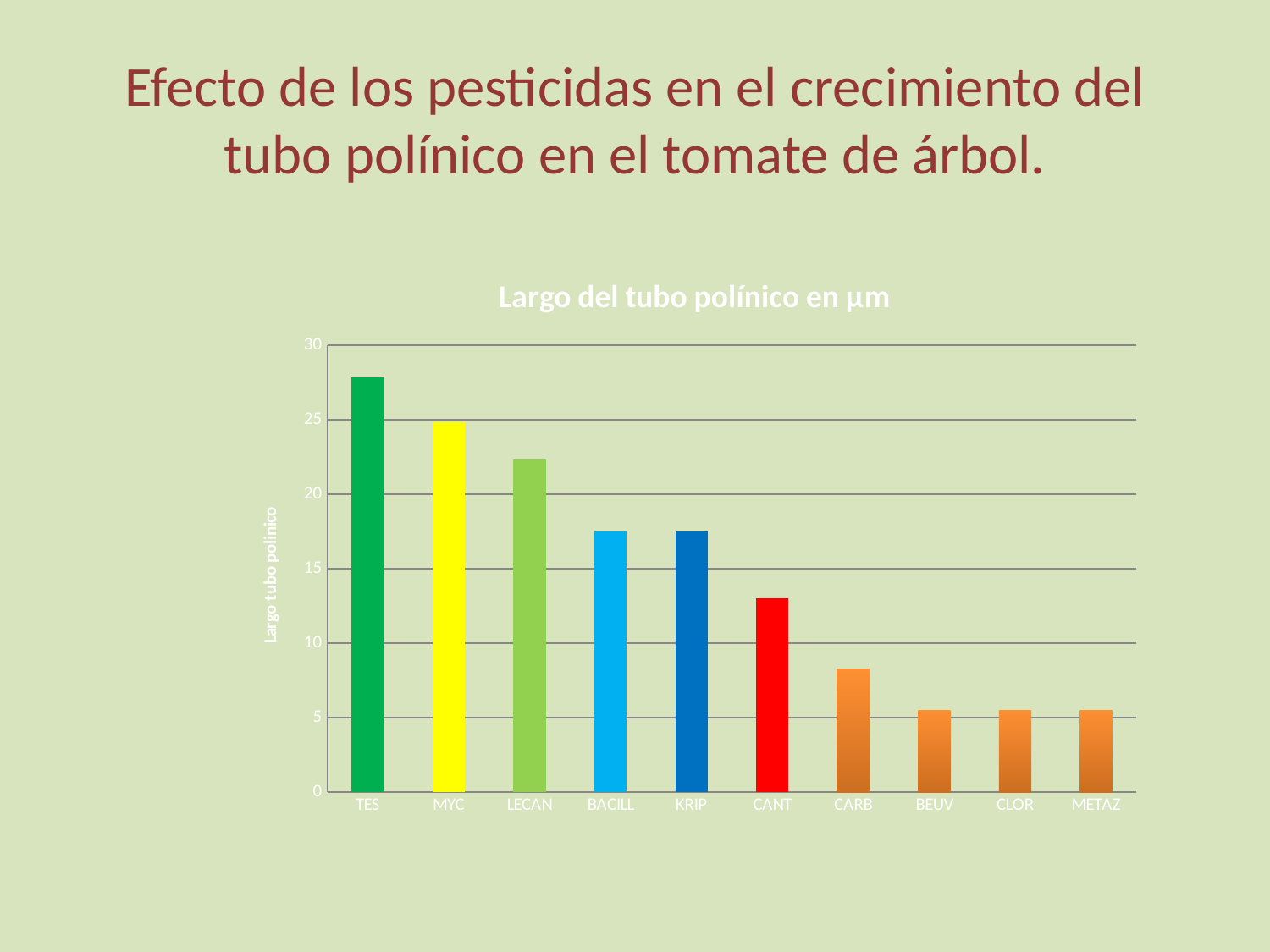
Is the value for CARB greater or less than 10? less Which is larger, the value for TES or the value for MYC? TES Is the value for METAZ greater or less than 10? less Is the value for BACILL greater or less than 15? greater Which category has the highest value in the chart? TES What kind of chart is shown on the slide? bar chart Do the values generally rise or fall from left to right along the x axis? fall What is the title of the chart? Largo del tubo polínico en μm How many categories are shown on the x axis of the chart? 10